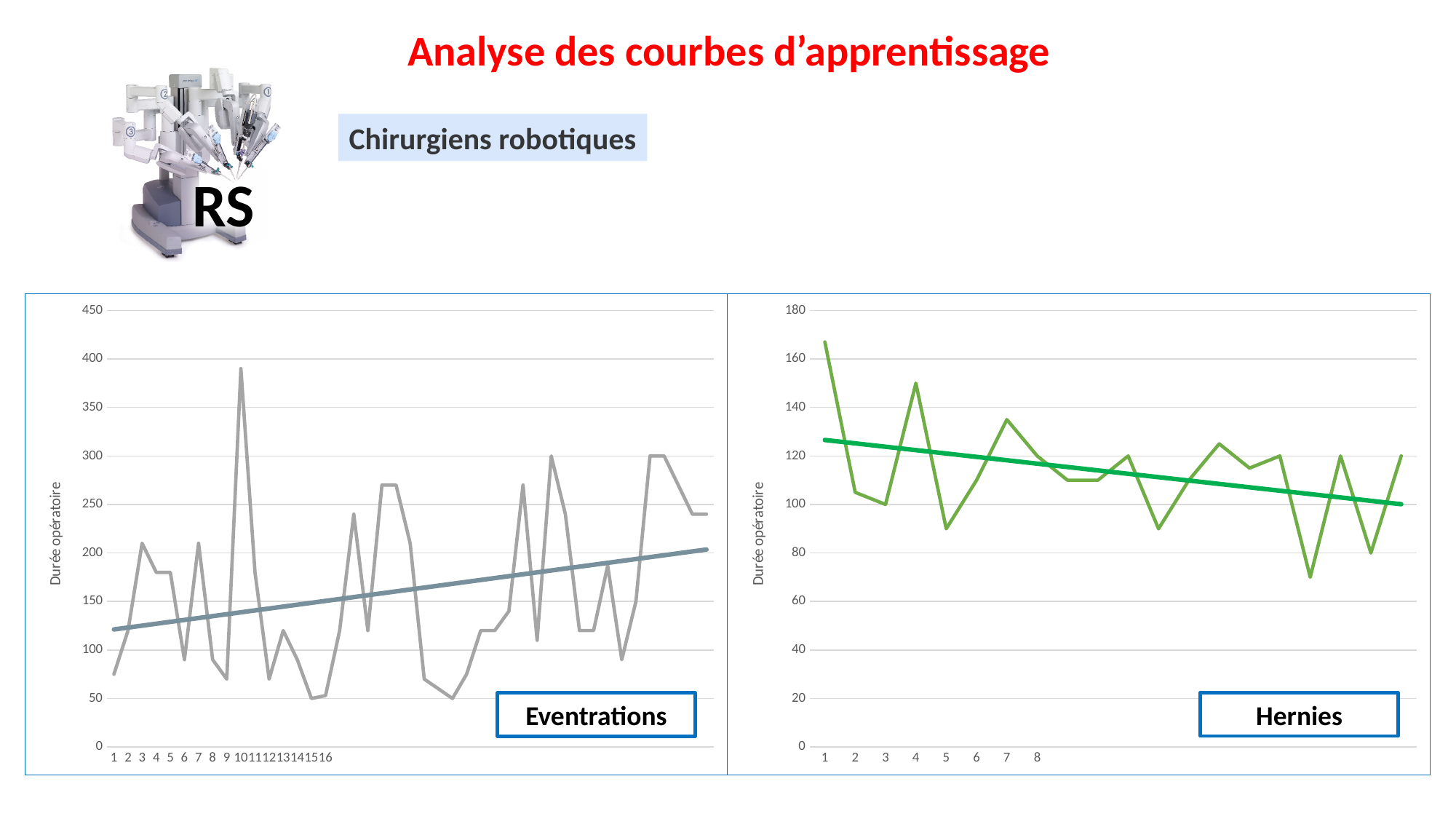
In the Hernies chart, is the value at point 1 greater or less than 160? greater In the Eventrations chart, does the trend line rise or fall along the x axis? rises What colour is the trend line in the Hernies chart? green What kind of chart is the Hernies chart on the right? line chart In the Hernies chart, is the value at point 3 greater or less than 120? less In the Eventrations chart, is the value at point 1 greater or less than 100? less What kind of chart is the Eventrations chart on the left? line chart In the Eventrations chart, which is larger, the value at point 10 or the value at point 1? point 10 In the Hernies chart, does the trend line rise or fall along the x axis? falls What is the y-axis label of the Hernies chart? Durée opératoire In the Eventrations chart, which labelled point on the x axis has the highest value? 10